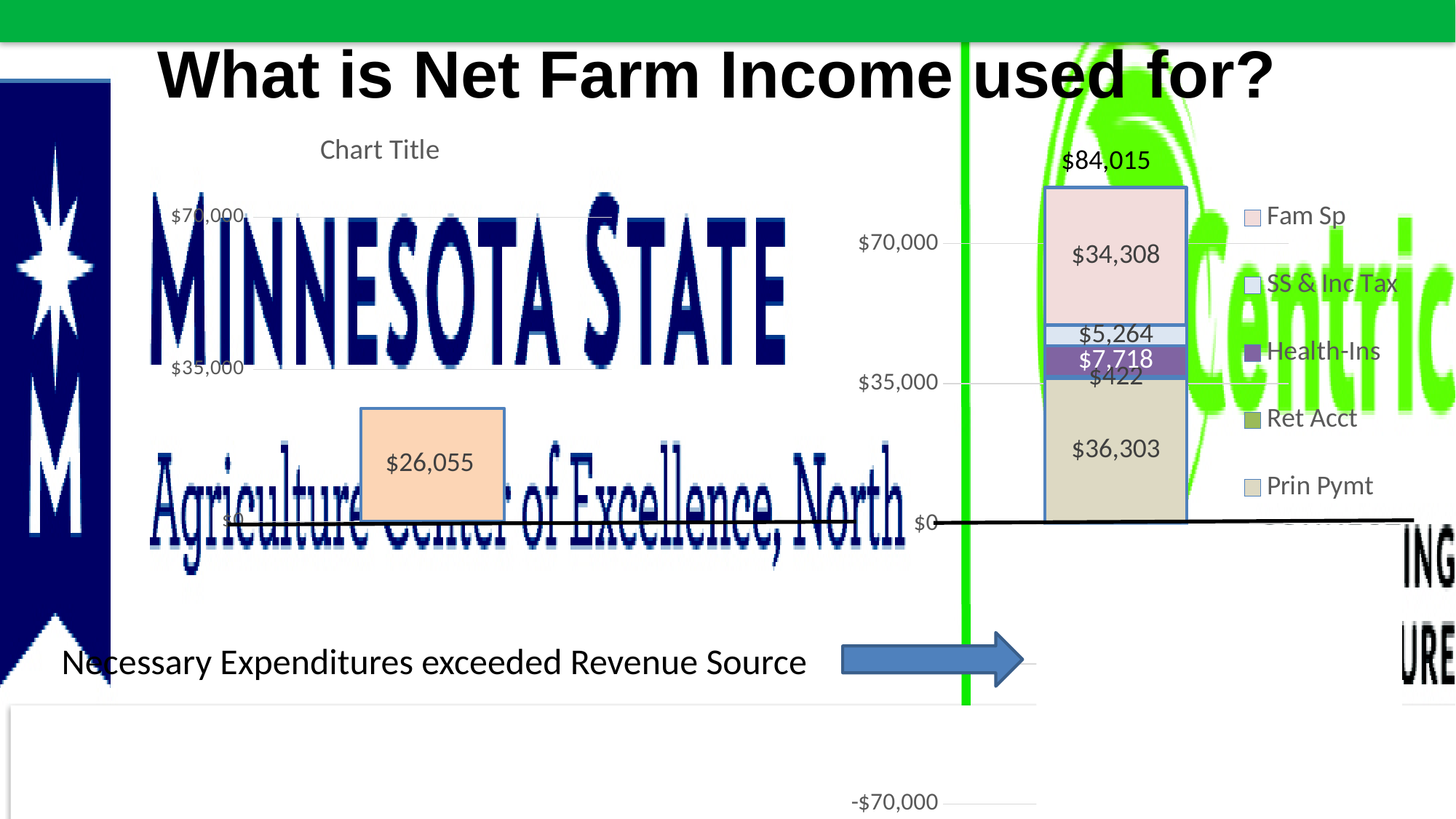
On the right stacked bar chart, what is the value of the SS & Inc Tax segment? $5,264 What kind of chart is the left chart titled "Chart Title"? bar chart How many series does the legend of the right stacked bar chart list? 5 On the left chart titled "Chart Title", what value is printed on the bar? $26,055 On the right stacked bar chart, what is the value of the Fam Sp segment? $34,308 On the left chart titled "Chart Title", is the bar's value greater or less than $35,000? less On the right stacked bar chart, what is the difference between the Health-Ins and SS & Inc Tax segments? $2,454 On the right stacked bar chart, which segment has the largest value? Prin Pymt On the right stacked bar chart, which segment has the smallest value? Ret Acct On the right stacked bar chart, what is the total printed above the stacked bar? $84,015 On the right stacked bar chart, what is the value of the Prin Pymt segment? $36,303 On the right stacked bar chart, what is the value of the Health-Ins segment? $7,718